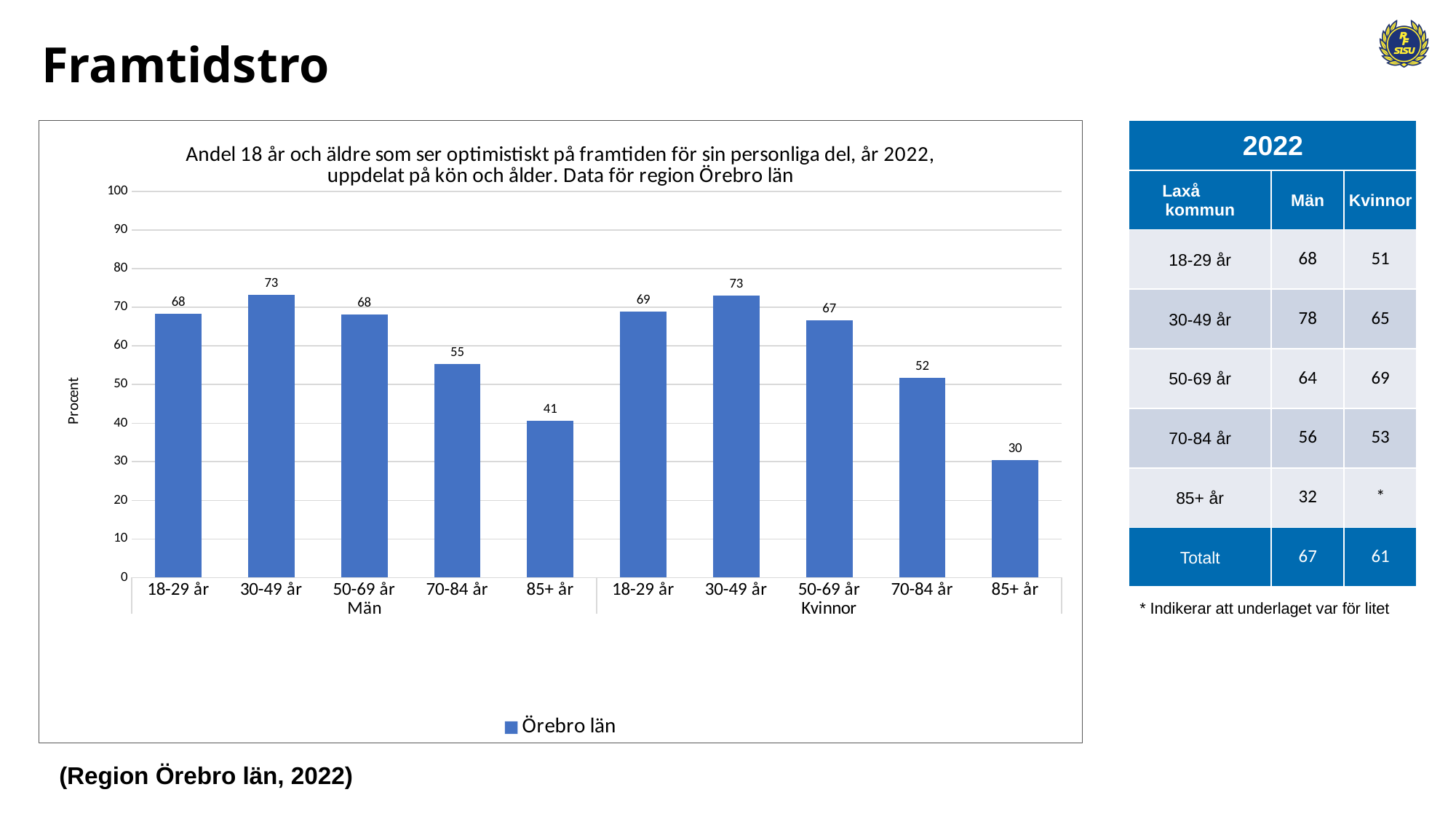
What kind of chart is shown? Bar chart Which is larger: the value for men aged 70-84 år or women aged 70-84 år? Men aged 70-84 år How many series does the legend list? 1 Which age group among women has the highest value? 30-49 år Is the value for women aged 50-69 år greater or less than 60? greater How many bars are plotted in the chart? 10 What is the difference between men aged 18-29 år and men aged 85+ år? 27 Which age group among men has the lowest value? 85+ år What is the value for women aged 85+ år? 30 What is the value for men aged 30-49 år? 73 What is the legend entry of the chart? Örebro län What is the value for women aged 70-84 år? 52